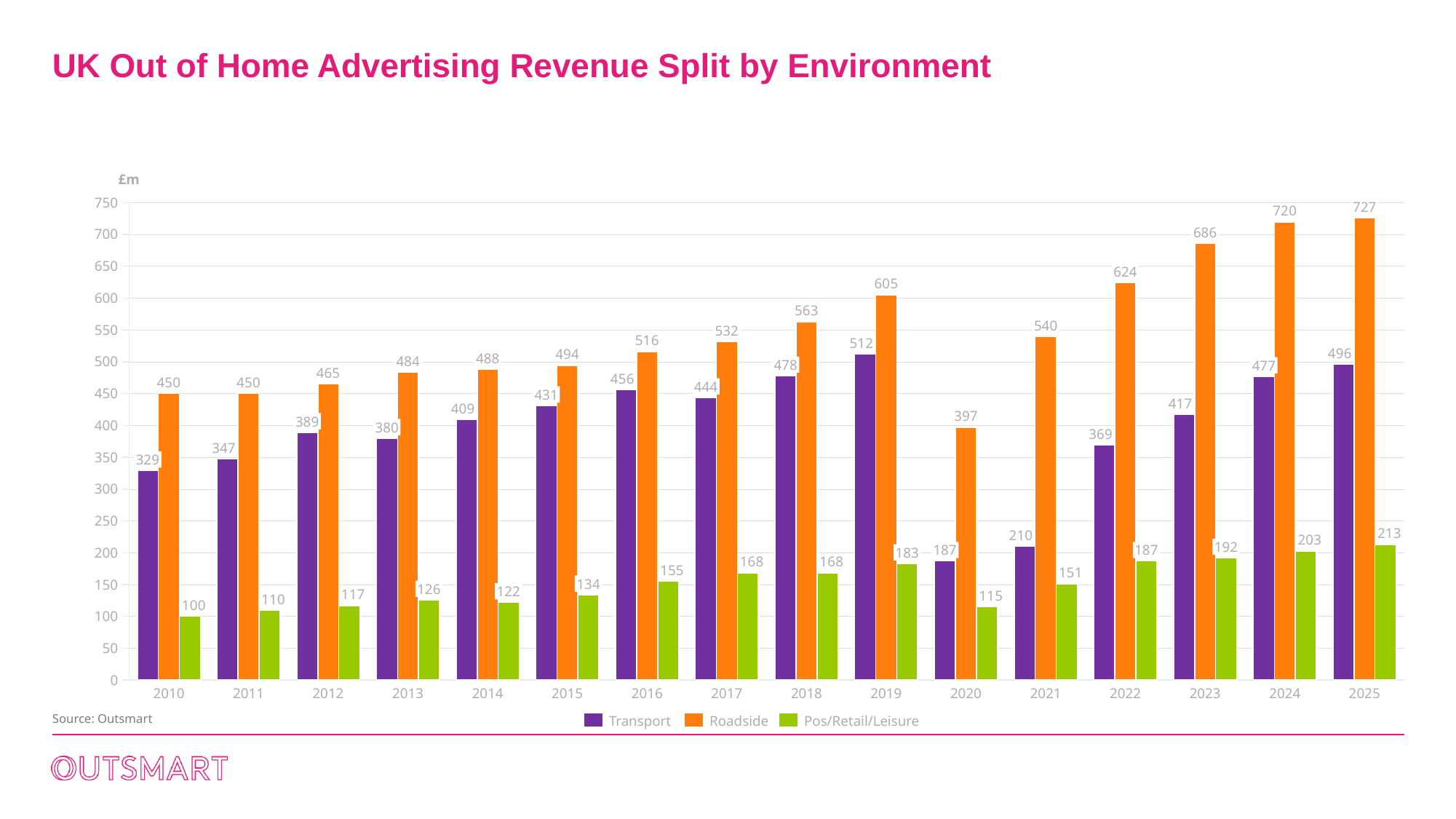
How many series does the legend list? 3 What is the difference between the Roadside and Transport revenue in 2025? 231 What kind of chart is shown on the slide? Bar chart In which year is the Pos/Retail/Leisure revenue lowest? 2010 What is the Roadside revenue for 2019? 605 Which is larger in 2021: Transport revenue or Pos/Retail/Leisure revenue? Transport How many years are shown on the x axis? 16 What is the Pos/Retail/Leisure revenue for 2025? 213 In which year is the Roadside revenue highest? 2025 What is the Transport revenue for 2020? 187 What unit is shown on the y axis? £m Does the Roadside revenue rise or fall from 2021 to 2025? Rise